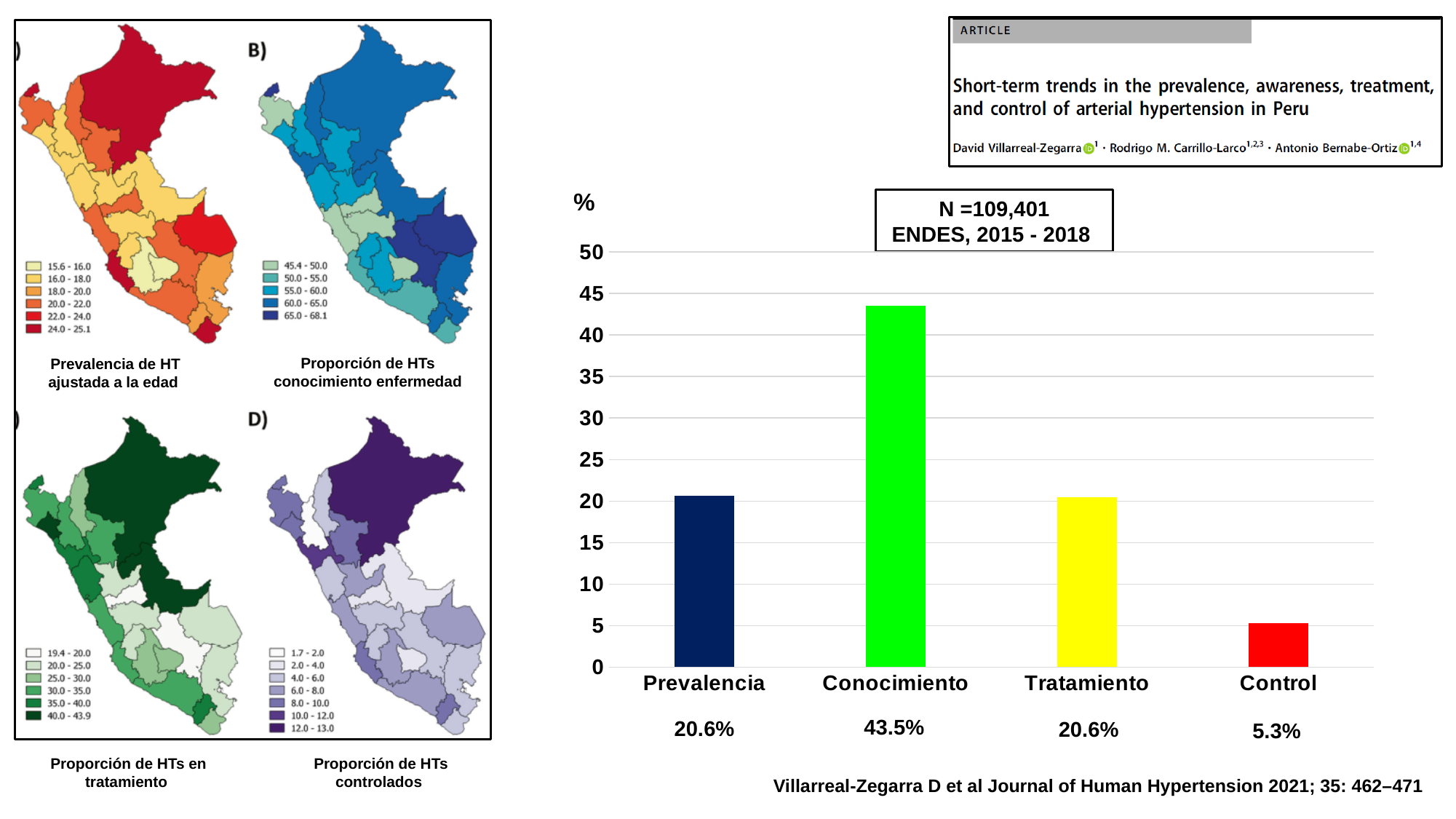
In the bar chart, which is larger, the value for Prevalencia or the value for Control? Prevalencia What kind of chart is the chart on the right side of the slide? bar chart In the bar chart, which category has the lowest value? Control In the bar chart, what is the value for Prevalencia? 20.6% In the bar chart, what is the difference between the values for Conocimiento and Control? 38.2% In the bar chart, what is the value for Control? 5.3% In the bar chart, what is the value for Conocimiento? 43.5% In the bar chart, what is the difference between the values for Conocimiento and Tratamiento? 22.9% In the bar chart, which category has the highest value? Conocimiento In the bar chart, what is the value for Tratamiento? 20.6% How many categories are shown in the bar chart? 4 In the bar chart, is the value for Conocimiento greater or less than 40? greater